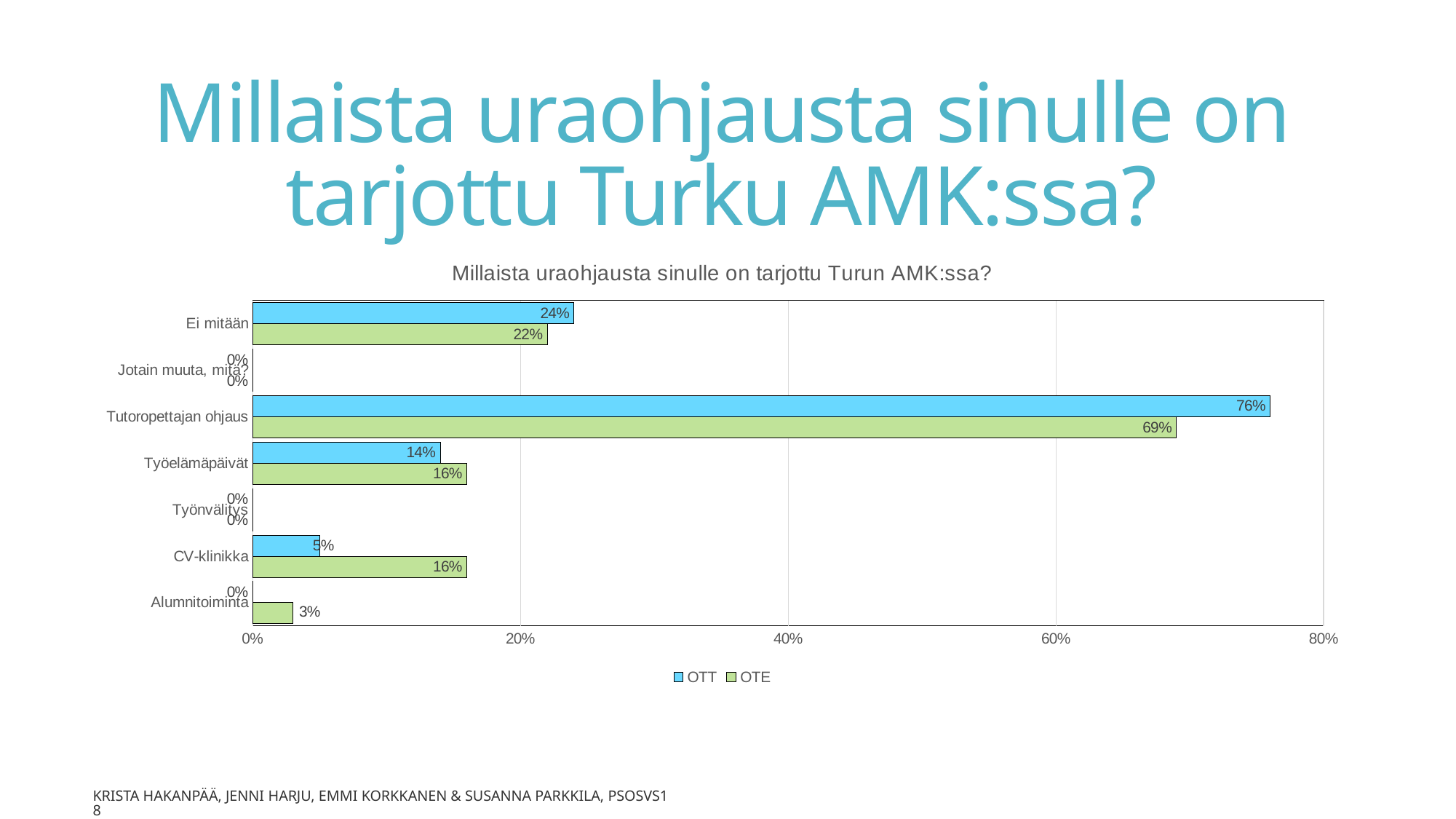
What is the OTE value for CV-klinikka? 16% What is the OTT value for Tutoropettajan ohjaus? 76% What kind of chart is shown on the slide? Bar chart What is the OTT value for Ei mitään? 24% How many series does the legend list? 2 What is the difference between the OTT and OTE values for Tutoropettajan ohjaus? 7% What is the OTE value for Alumnitoiminta? 3% What is the difference between the OTE and OTT values for CV-klinikka? 11% Which is larger for Työelämäpäivät, the OTT value or the OTE value? OTE How many categories are shown on the y axis of the chart? 7 Which category has the highest OTE value? Tutoropettajan ohjaus Which series is shown in green in the legend? OTE